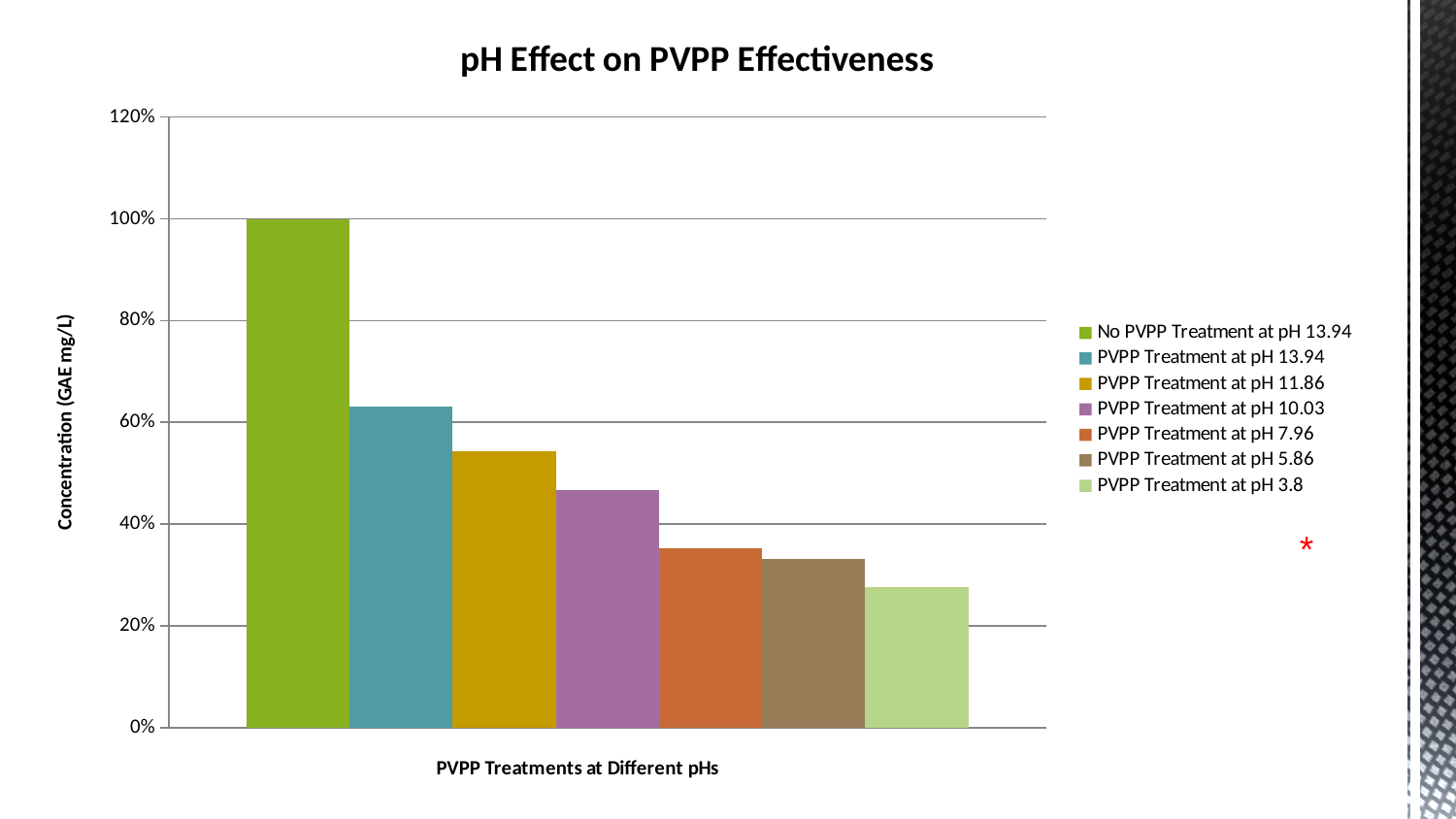
Which series has the highest value? No PVPP Treatment at pH 13.94 Which series has the lowest value? PVPP Treatment at pH 3.8 What is the label of the vertical axis? Concentration (GAE mg/L) How many series does the legend list? 7 What is the value for No PVPP Treatment at pH 13.94? 100% Do the bar values rise or fall from left to right across the chart? Fall What type of chart is shown on the slide? Bar chart Is the value for PVPP Treatment at pH 13.94 greater or less than 60%? greater Which is larger: the value for PVPP Treatment at pH 13.94 or PVPP Treatment at pH 11.86? PVPP Treatment at pH 13.94 How many bars are plotted in the chart? 7 What is the title of the chart? pH Effect on PVPP Effectiveness Is the value for PVPP Treatment at pH 3.8 greater or less than 40%? less